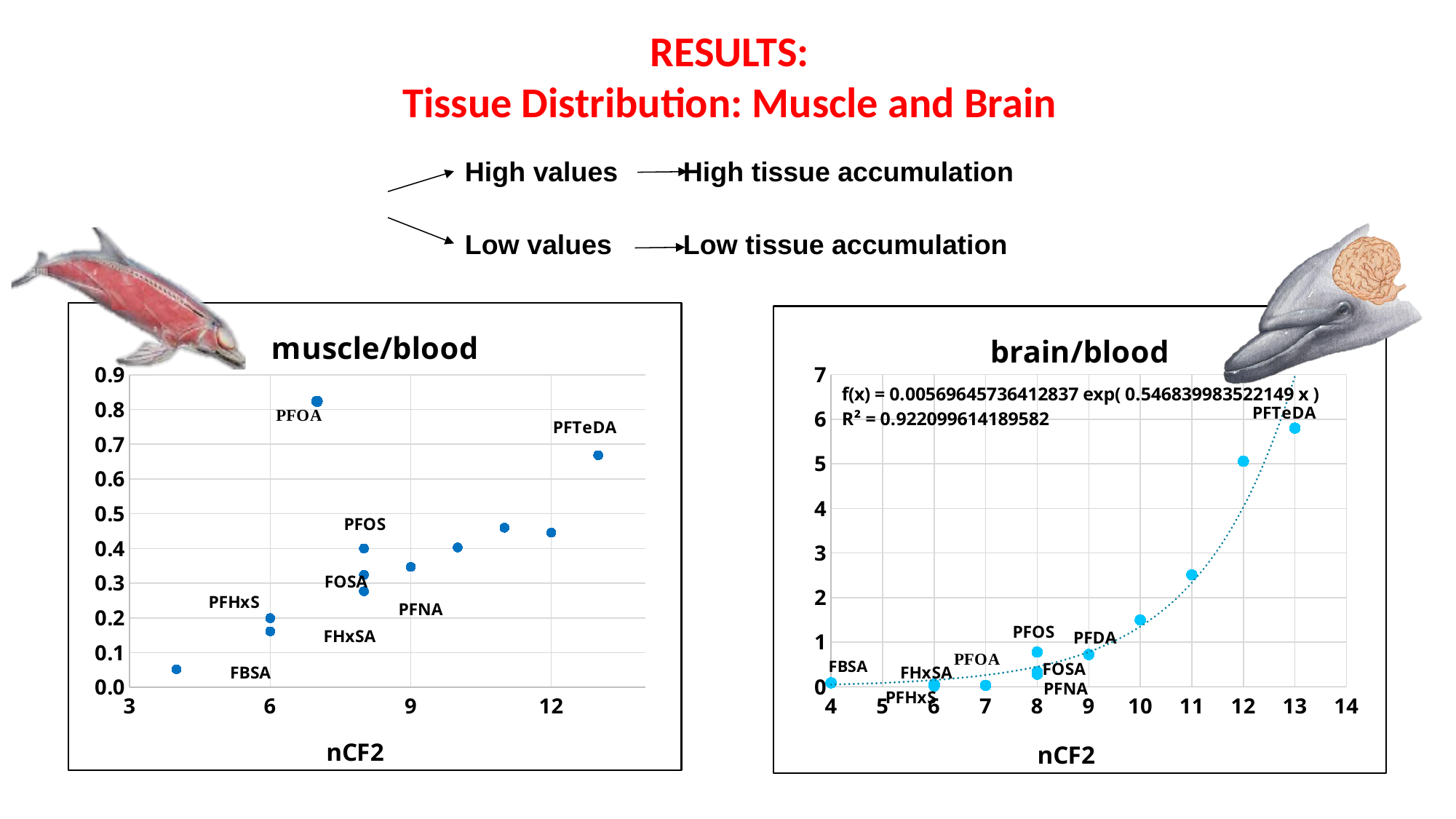
In the brain/blood chart, which labelled compound has the highest value? PFTeDA In the brain/blood chart, is the value for PFOS greater or less than 1? less In the muscle/blood chart, is the value for PFOA greater or less than 0.7? greater In the muscle/blood chart, which labelled compound has the highest value? PFOA In the muscle/blood chart, which is larger, the value for PFOA or the value for PFTeDA? PFOA What kind of chart is the muscle/blood chart? scatter chart In the muscle/blood chart, which labelled compound has the lowest value? FBSA In the brain/blood chart, is the value for PFTeDA greater or less than 5? greater What R² value is printed on the brain/blood chart? 0.922099614189582 In the brain/blood chart, which is larger, the value for PFOS or the value for FOSA? PFOS In the brain/blood chart, do the values generally rise or fall as nCF2 increases? rise